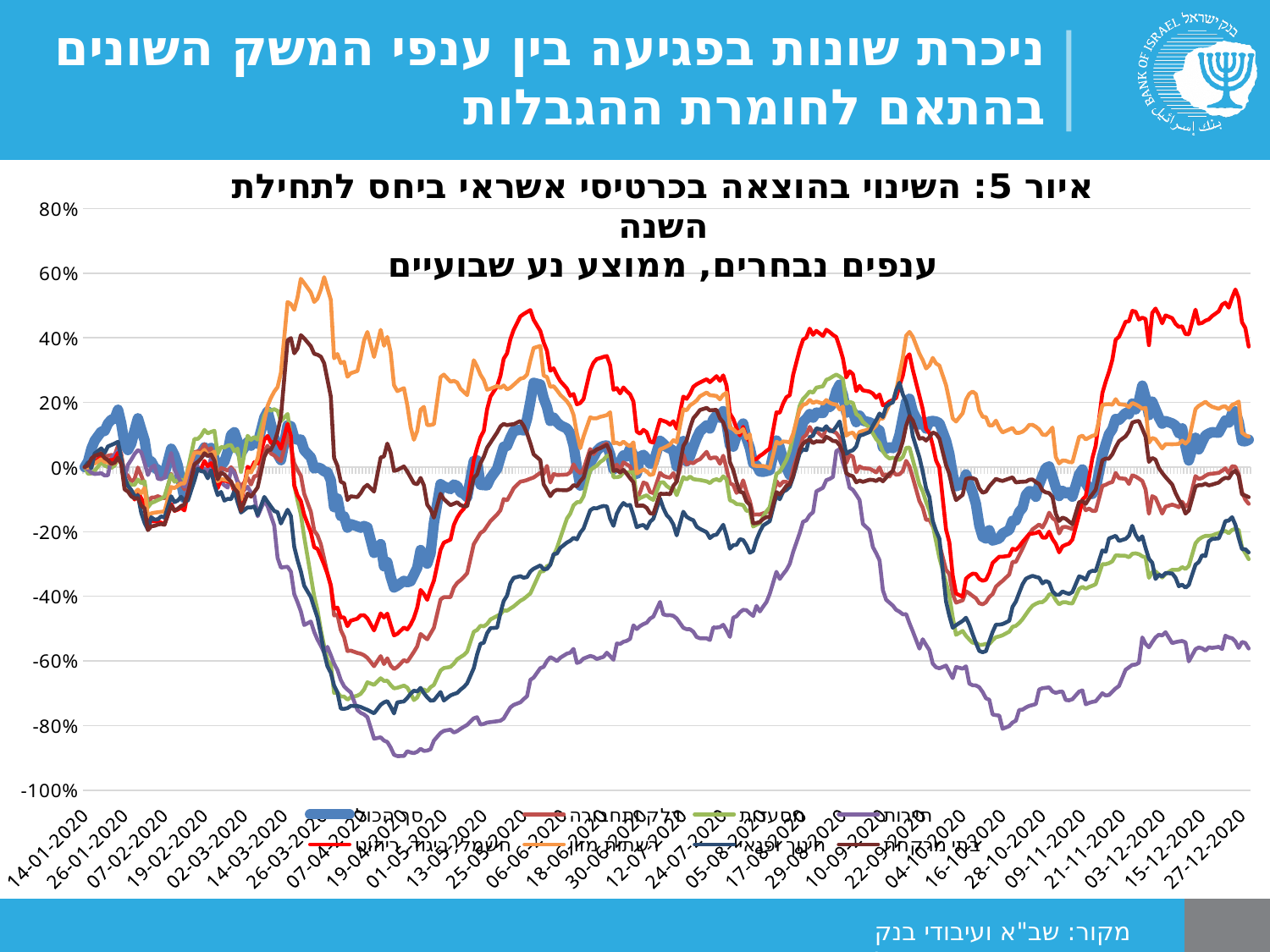
What is the highest value shown on the vertical axis of the chart? 80% Is the lowest value reached by any line in the chart greater or less than -80%? less Is the value of the purple line at the end of the chart (27-12-2020) greater or less than -40%? less What is the last date shown on the horizontal axis of the chart? 27-12-2020 How many lines (series) are plotted in the chart? 8 Is the highest value reached by any line in the chart greater or less than 40%? greater What is the lowest value shown on the vertical axis of the chart? -100% What kind of chart is shown on the slide? line chart What is the first date shown on the horizontal axis of the chart? 14-01-2020